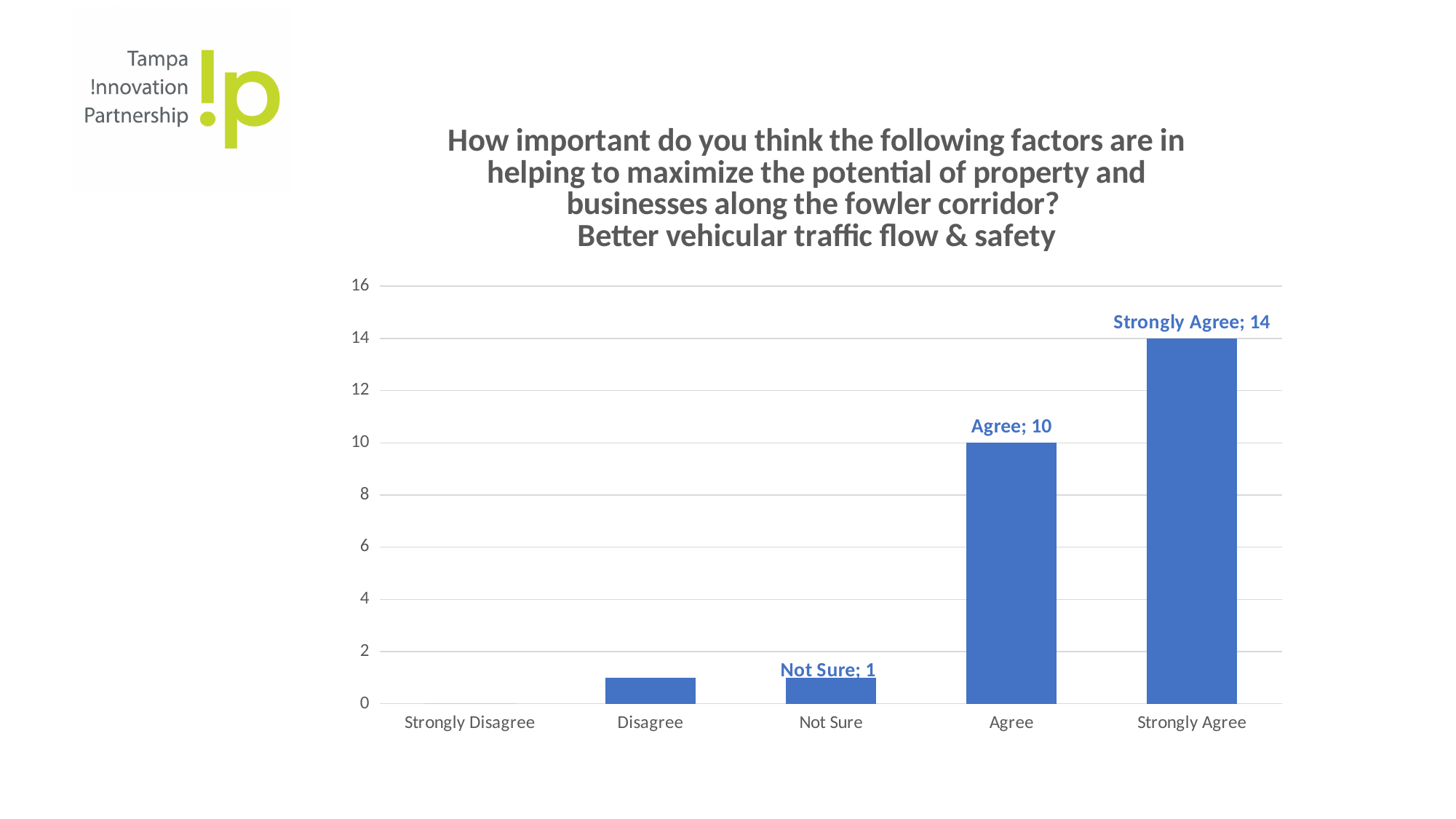
What is the value for Agree? 10 Do the values generally rise or fall from Strongly Disagree to Strongly Agree along the x axis? rise What is the value for Strongly Agree? 14 Is the value for Disagree greater or less than 2? less How many categories are shown on the x axis? 5 Which category has the highest value? Strongly Agree Which is larger, the value for Agree or the value for Not Sure? Agree Which factor is named in the last line of the chart title? Better vehicular traffic flow & safety What kind of chart is shown on the slide? bar chart Which category has the lowest value? Strongly Disagree What is the value for Not Sure? 1 What is the difference between the values for Strongly Agree and Agree? 4